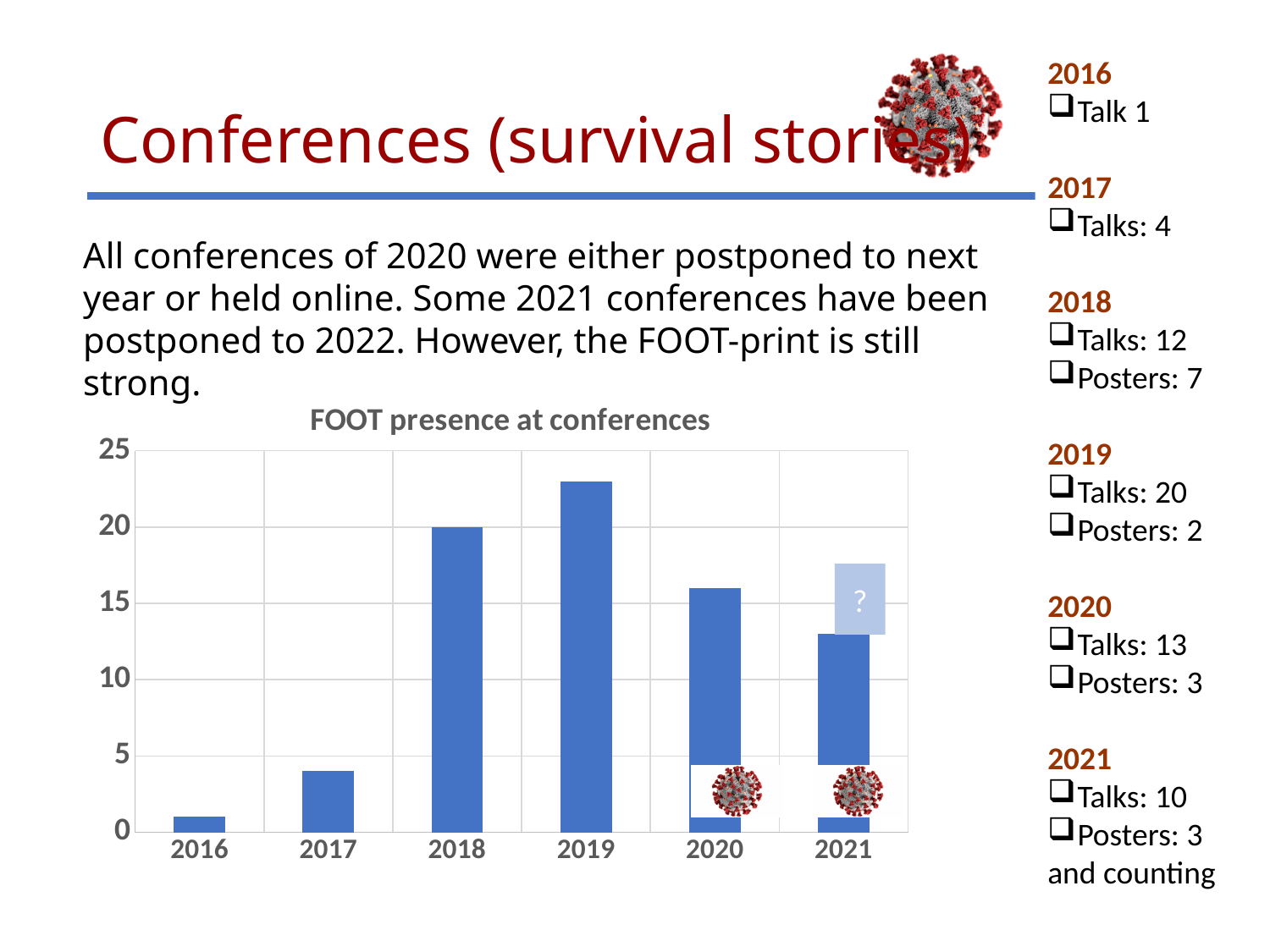
Is the value for 2019 greater or less than 20? greater Which year has the larger bar, 2018 or 2020? 2018 How many years are shown on the x axis of the chart? 6 Which year has the highest bar in the chart? 2019 Do the bars rise or fall from 2016 to 2019? rise What is the value of the bar for 2018? 20 Is the value for 2017 greater or less than 5? less Is the value for 2020 greater or less than 15? greater What is the title of the chart? FOOT presence at conferences Which year has the lowest bar in the chart? 2016 What kind of chart is shown on the slide? Bar chart